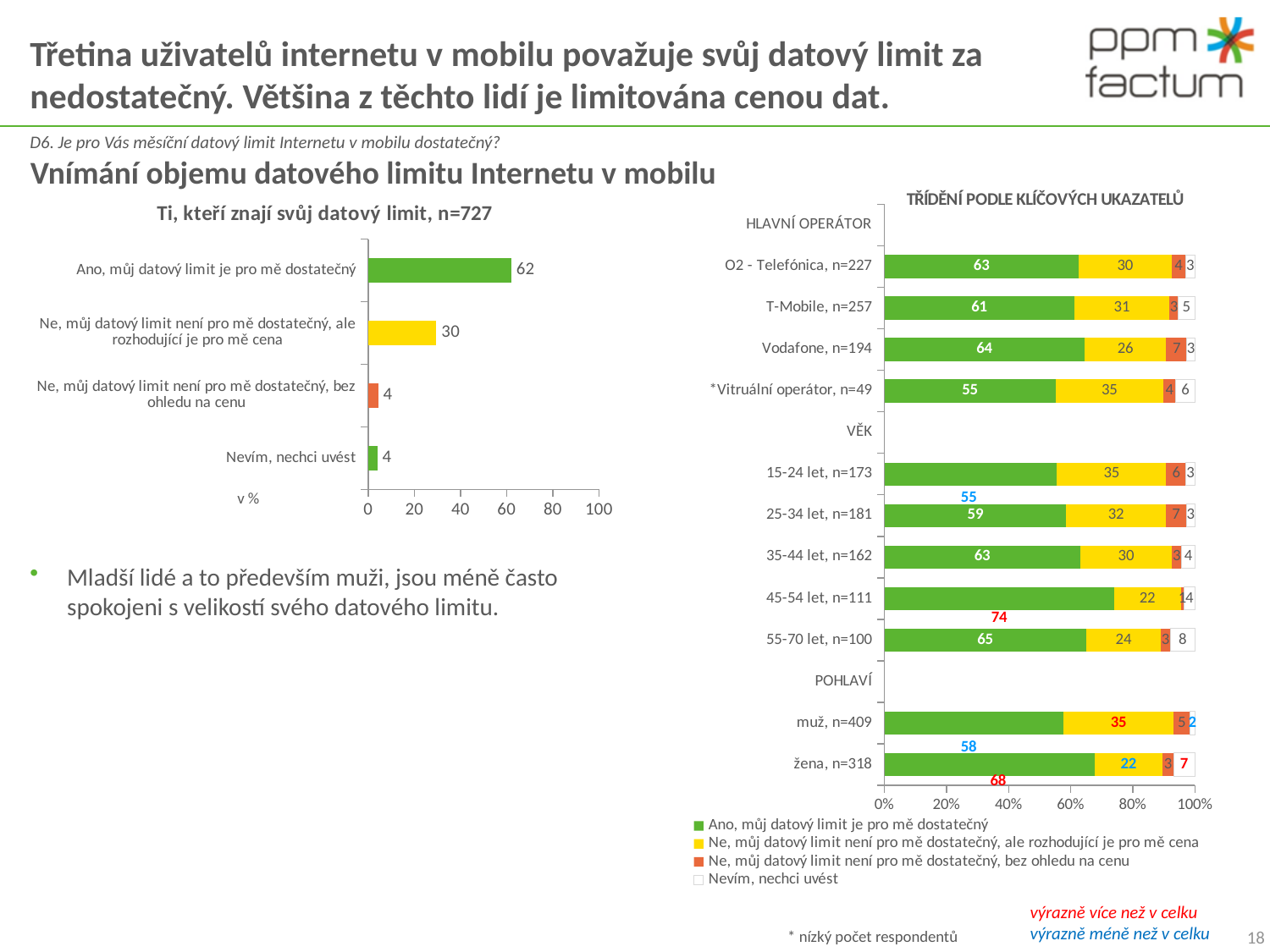
In the right chart 'TŘÍDĚNÍ PODLE KLÍČOVÝCH UKAZATELŮ', what is the value of 'Ne, můj datový limit není pro mě dostatečný, ale rozhodující je pro mě cena' for 'muž, n=409'? 35 In the right chart 'TŘÍDĚNÍ PODLE KLÍČOVÝCH UKAZATELŮ', which age group has the highest value for 'Ano, můj datový limit je pro mě dostatečný'? 45-54 let, n=111 What kind of chart is the left chart 'Ti, kteří znají svůj datový limit, n=727'? Bar chart In the right chart 'TŘÍDĚNÍ PODLE KLÍČOVÝCH UKAZATELŮ', which age group has the lowest value for 'Ano, můj datový limit je pro mě dostatečný'? 15-24 let, n=173 In the left chart 'Ti, kteří znají svůj datový limit, n=727', how many categories are shown? 4 In the left chart 'Ti, kteří znají svůj datový limit, n=727', which category has the highest value? Ano, můj datový limit je pro mě dostatečný In the left chart 'Ti, kteří znají svůj datový limit, n=727', what is the difference between 'Ano, můj datový limit je pro mě dostatečný' and 'Ne, můj datový limit není pro mě dostatečný, ale rozhodující je pro mě cena'? 32 In the right chart 'TŘÍDĚNÍ PODLE KLÍČOVÝCH UKAZATELŮ', what is the value of 'Ano, můj datový limit je pro mě dostatečný' for 'O2 - Telefónica, n=227'? 63 In the right chart 'TŘÍDĚNÍ PODLE KLÍČOVÝCH UKAZATELŮ', which has the larger value for 'Ano, můj datový limit je pro mě dostatečný': 'žena, n=318' or 'muž, n=409'? žena, n=318 In the right chart 'TŘÍDĚNÍ PODLE KLÍČOVÝCH UKAZATELŮ', how many series does the legend list? 4 In the left chart 'Ti, kteří znají svůj datový limit, n=727', what is the value for 'Ano, můj datový limit je pro mě dostatečný'? 62 In the right chart 'TŘÍDĚNÍ PODLE KLÍČOVÝCH UKAZATELŮ', what is the value of 'Ano, můj datový limit je pro mě dostatečný' for '45-54 let, n=111'? 74